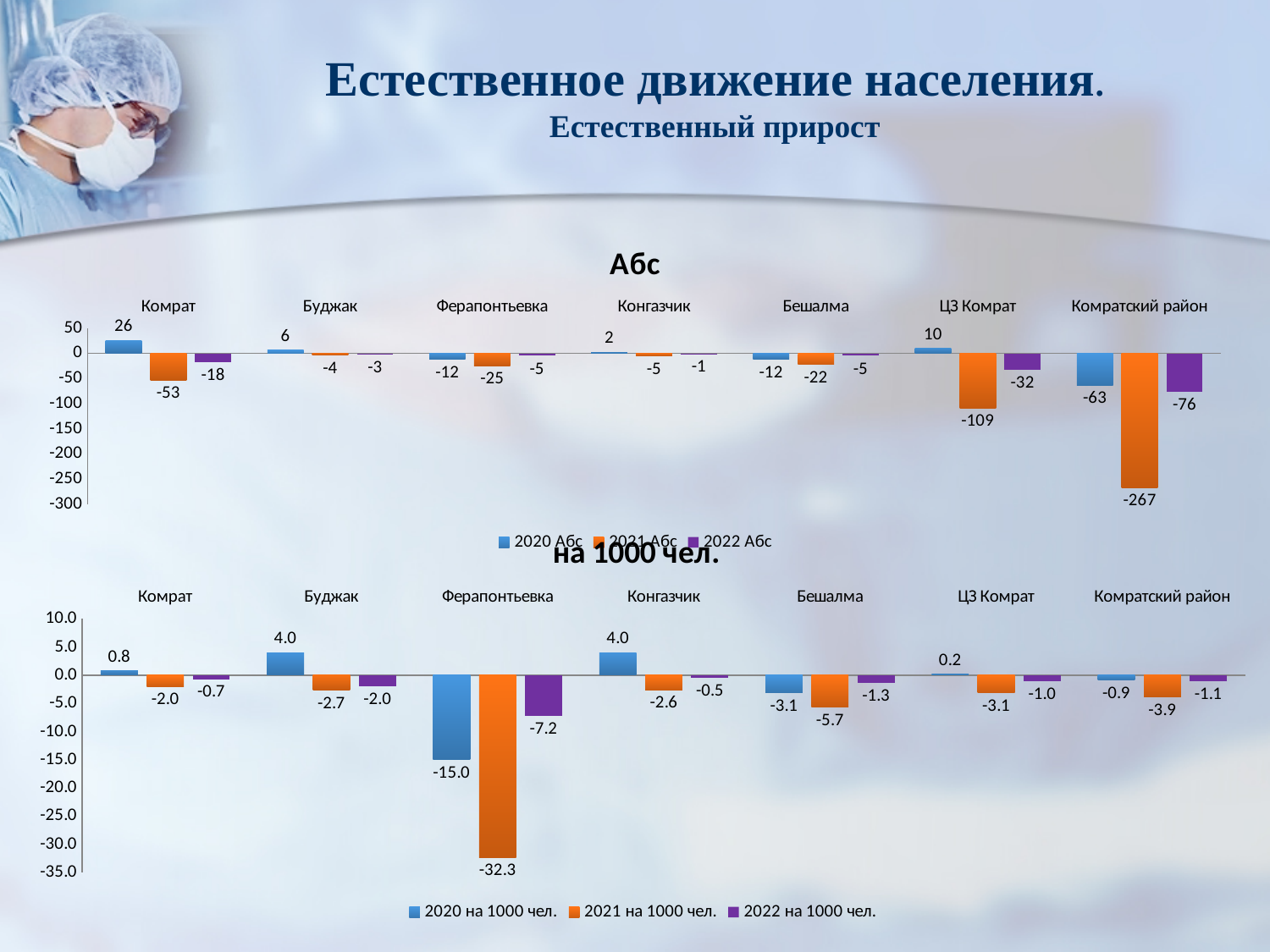
In the 'Абс' chart, what is the 2021 Абс value for Комратский район? -267 In the 'на 1000 чел.' chart, what is the 2021 value for Ферапонтьевка? -32.3 In the 'Абс' chart, what is the difference between the 2020 Абс and 2021 Абс values for ЦЗ Комрат? 119 In the 'на 1000 чел.' chart, which category has the lowest 2020 value? Ферапонтьевка What kind of chart is the 'на 1000 чел.' chart? Bar chart In the 'на 1000 чел.' chart, how many categories are shown on the x axis? 7 In the 'на 1000 чел.' chart, which is larger: the 2020 value for Буджак or the 2020 value for Комрат? Буджак In the 'Абс' chart, how many series does the legend list? 3 In the 'Абс' chart, what is the 2022 Абс value for ЦЗ Комрат? -32 In the 'на 1000 чел.' chart, what is the 2022 value for Бешалма? -1.3 In the 'Абс' chart, what is the 2020 Абс value for Комрат? 26 In the 'Абс' chart, which category has the lowest 2021 Абс value? Комратский район